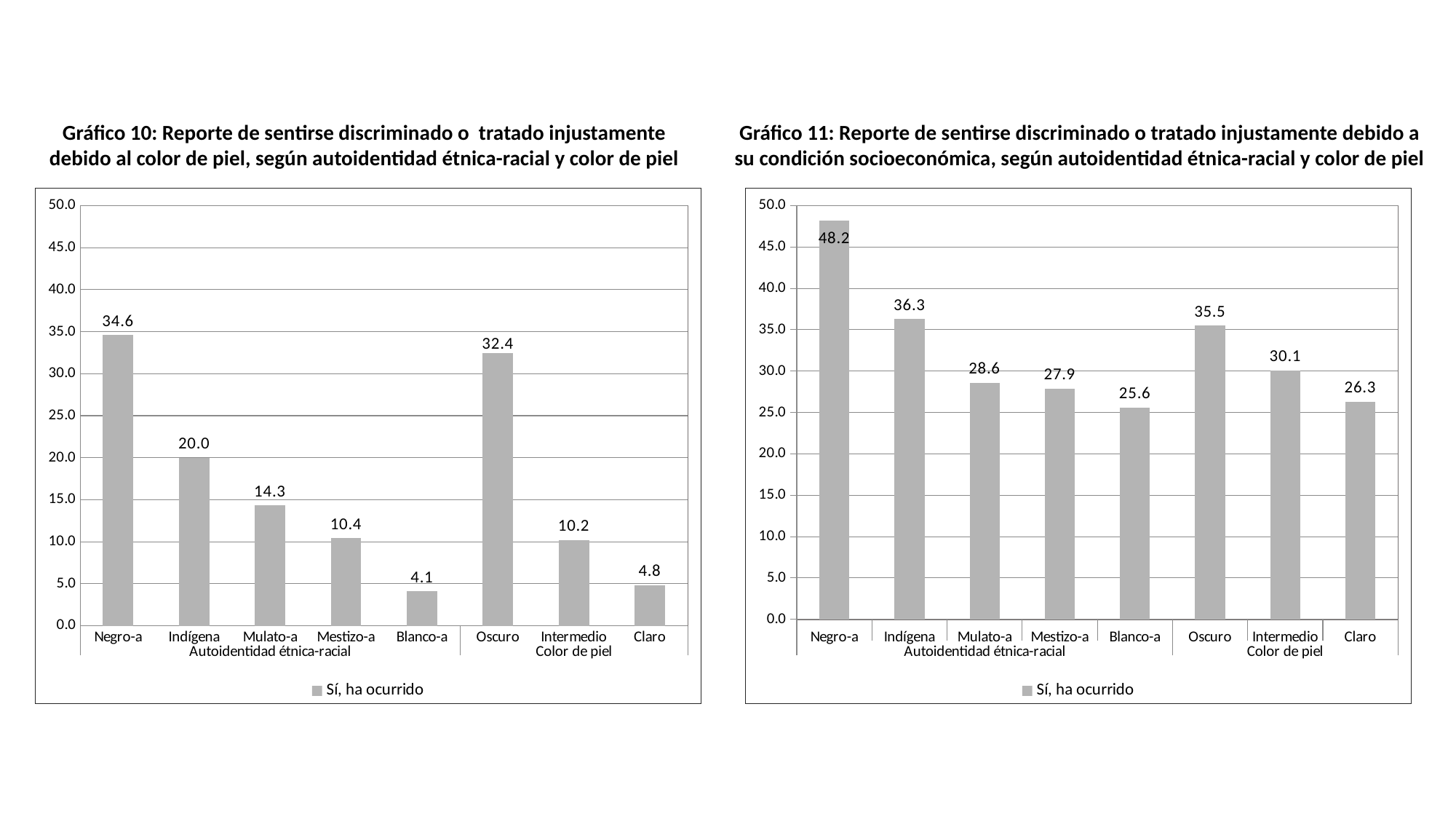
In Gráfico 11 (right chart), what is the difference between the values for Negro-a and Indígena? 11.9 In Gráfico 11 (right chart), which category has the lowest value? Blanco-a In Gráfico 11 (right chart), how many series does the legend list? 1 What kind of chart is Gráfico 10 (left chart)? Bar chart In Gráfico 10 (left chart), what is the value for Negro-a? 34.6 In Gráfico 10 (left chart), what is the difference between the values for Oscuro and Claro? 27.6 In Gráfico 11 (right chart), is the value for Mestizo-a greater or less than 30.0? less In Gráfico 10 (left chart), which is larger, the value for Mulato-a or the value for Mestizo-a? Mulato-a In Gráfico 11 (right chart), what is the value for Intermedio? 30.1 In Gráfico 10 (left chart), how many categories are plotted? 8 In Gráfico 11 (right chart), which category has the highest value? Negro-a In Gráfico 10 (left chart), which category has the lowest value? Blanco-a